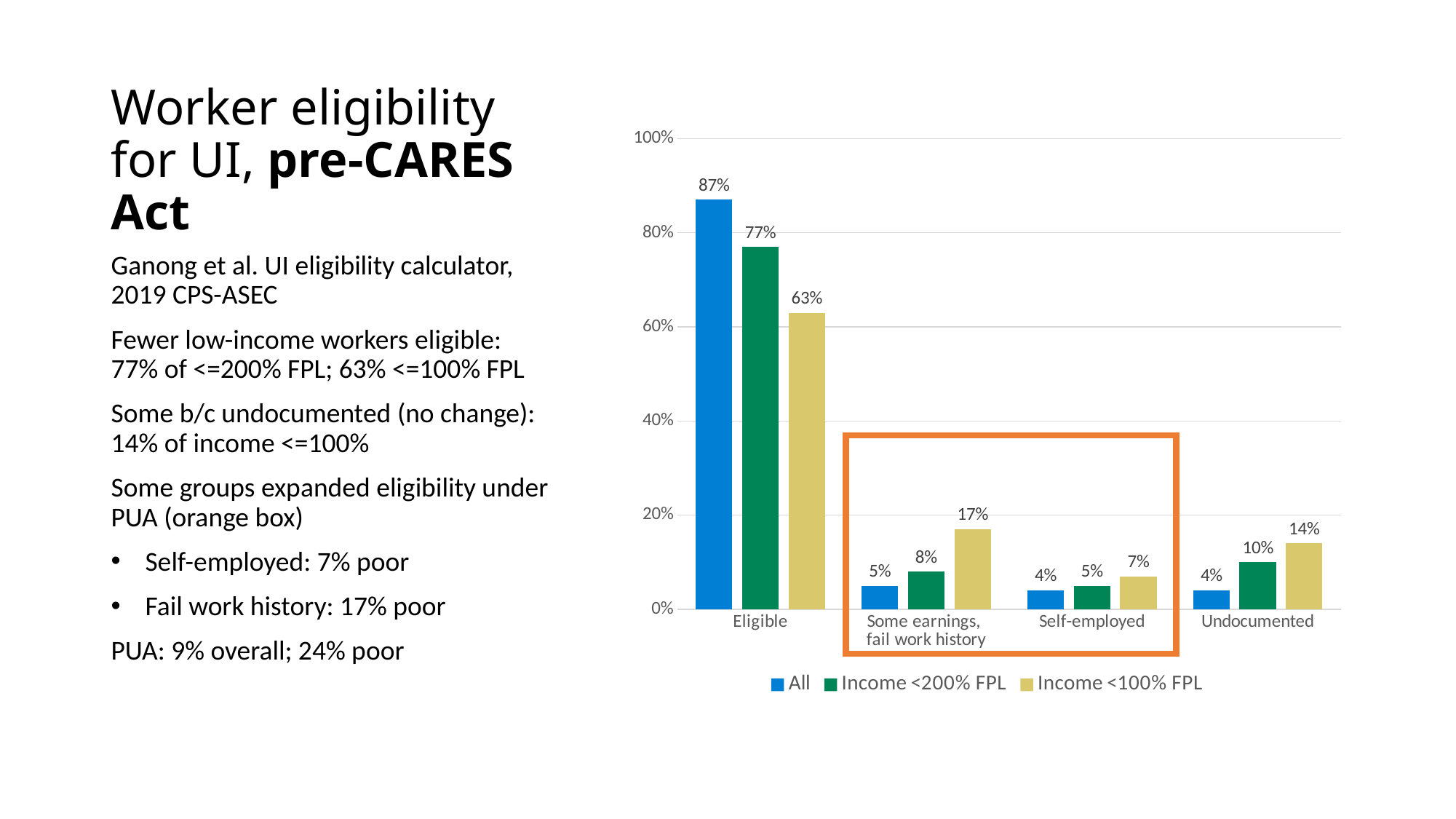
Which category has the highest value for the All series? Eligible How many categories are shown on the x axis? 4 Which is larger in the Undocumented category: the Income <200% FPL value or the Income <100% FPL value? Income <100% FPL What is the value for All in the Eligible category? 87% How many series does the legend list? 3 What is the value for Income <200% FPL in the Undocumented category? 10% Which category has the lowest value for the Income <100% FPL series? Self-employed What kind of chart is shown on the slide? bar chart Which categories are enclosed by the orange box on the chart? Some earnings, fail work history and Self-employed What is the value for Income <100% FPL in the Some earnings, fail work history category? 17% Is the value for Income <200% FPL in the Eligible category greater or less than 60%? greater What is the difference between the All and Income <100% FPL values in the Eligible category? 24%